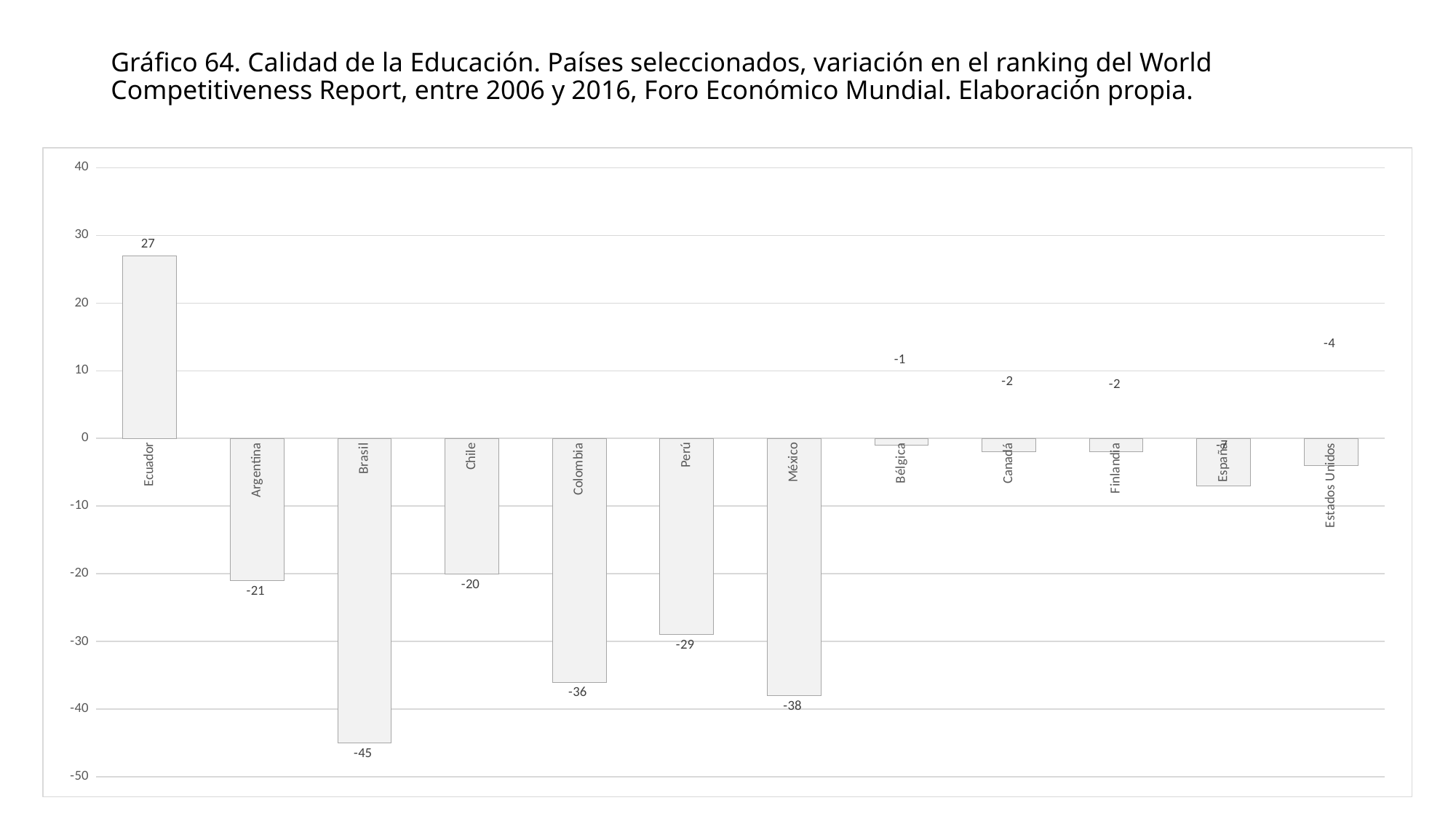
What is the value for Ecuador? 27 Which country has the lowest value? Brasil Which two countries share the value -2? Canadá and Finlandia What is the difference between the values for Colombia and Perú? 7 What kind of chart is shown on the slide? Bar chart What is the value for México? -38 What is the value for Brasil? -45 What is the value for Estados Unidos? -4 Which has a larger value, Argentina or Chile? Chile How many countries are shown on the chart? 12 Which country has the highest value? Ecuador Is the value for España greater or less than -10? greater